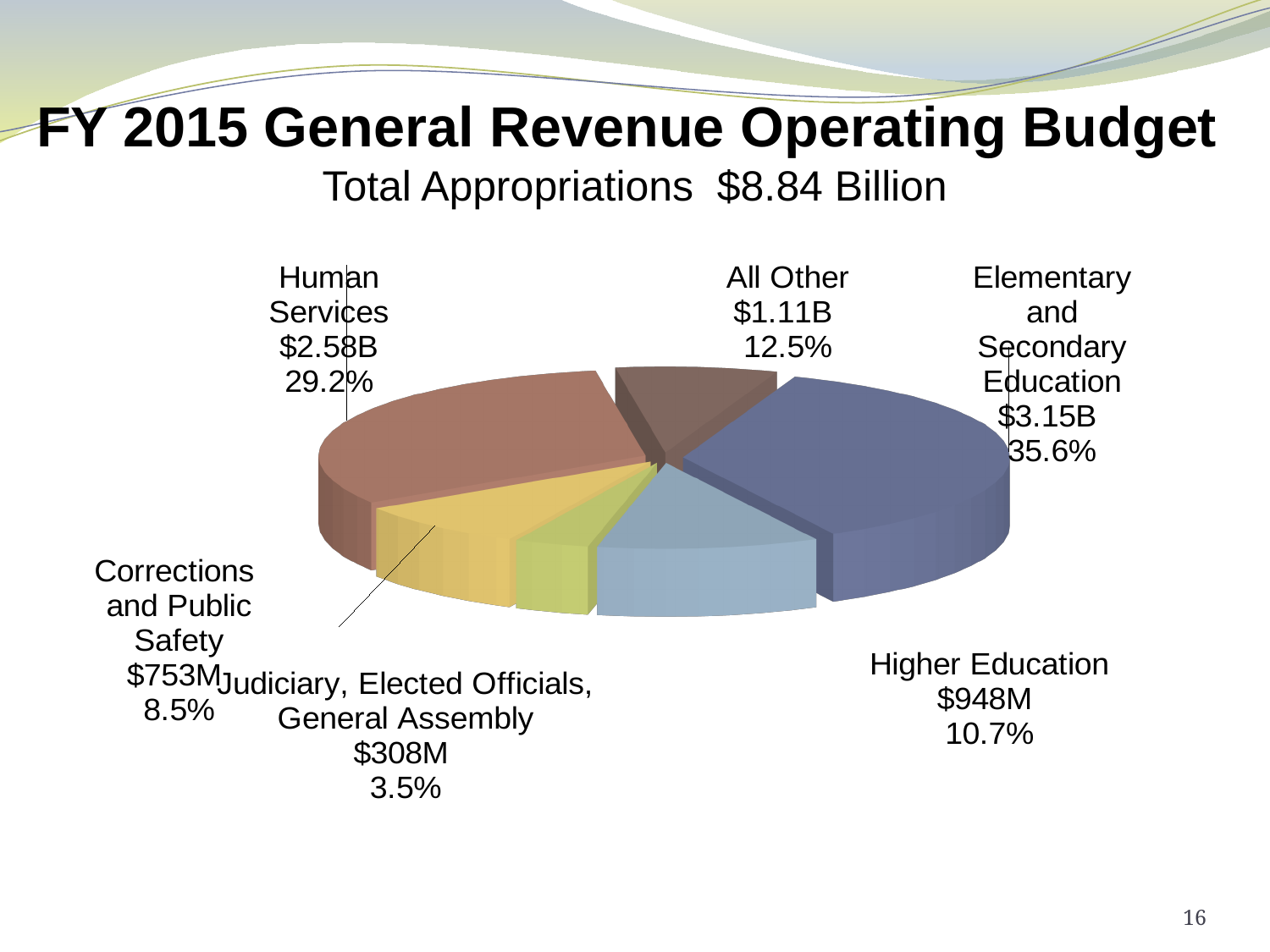
What is the dollar amount appropriated for Human Services? $2.58B What is the dollar amount for Corrections and Public Safety? $753M Which category receives the smallest share of the budget? Judiciary, Elected Officials, General Assembly What share of the FY 2015 General Revenue Operating Budget goes to Elementary and Secondary Education? 35.6% What is the total appropriations amount stated in the chart subtitle? $8.84 Billion Which category receives the largest share of the budget? Elementary and Secondary Education What is the difference in percentage points between the Elementary and Secondary Education share and the Human Services share? 6.4 percentage points What is the dollar amount appropriated for Higher Education? $948M Which is larger: the share for Corrections and Public Safety or the share for Higher Education? Higher Education How many categories are shown in the pie chart? 6 What percentage of the budget is labeled as All Other? 12.5% What type of chart is shown on the slide? Pie chart